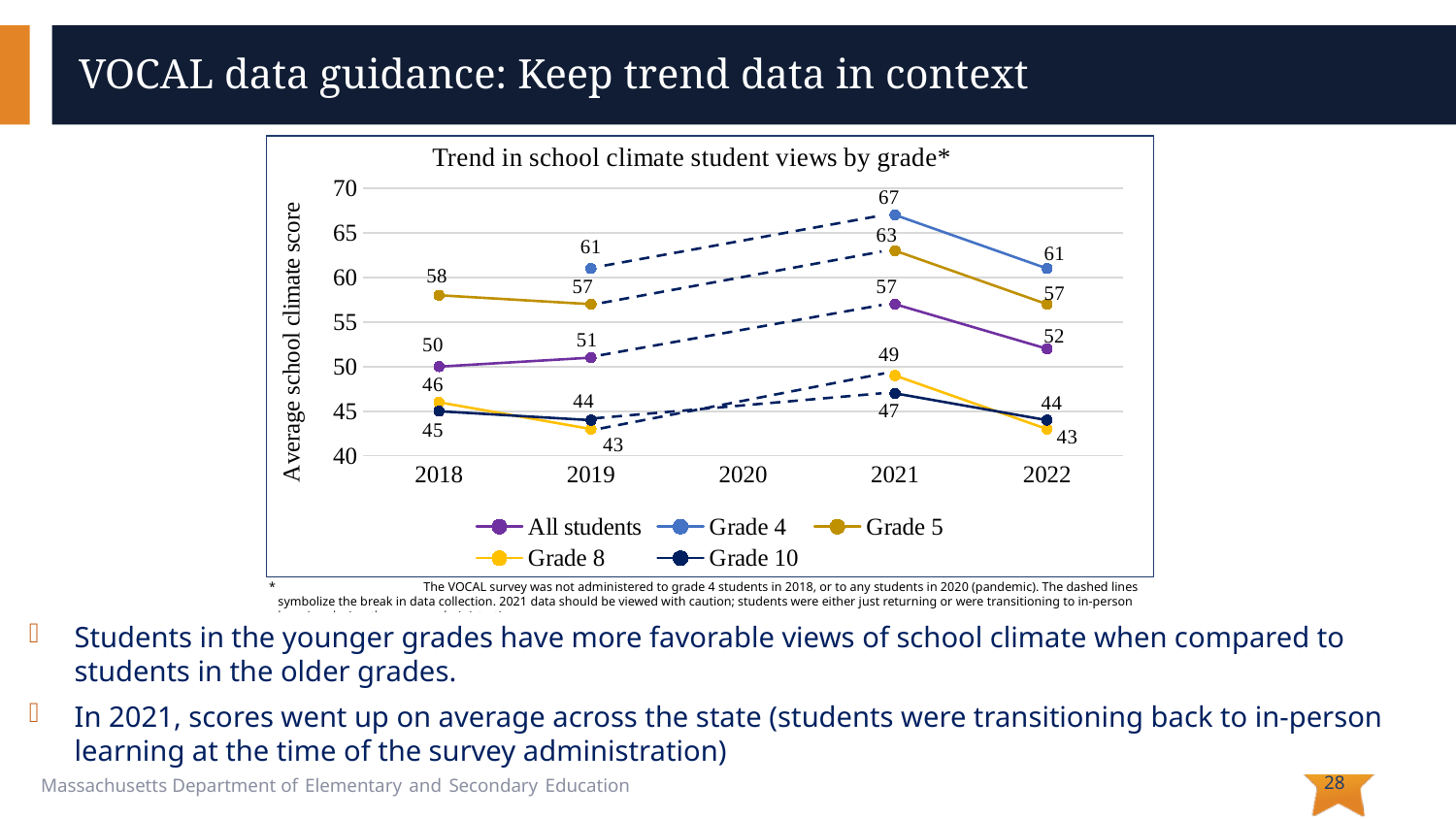
Which series has the lowest score in 2019? Grade 8 What is the title of the chart? Trend in school climate student views by grade* What is the Grade 8 average school climate score in 2022? 43 How many series does the legend list? 5 What kind of chart is shown on the slide? Line chart What is the All students average school climate score in 2018? 50 Does the All students score rise or fall from 2021 to 2022? Fall What is the Grade 4 average school climate score in 2021? 67 Which series has the highest score in 2021? Grade 4 What is the difference between the Grade 4 and Grade 5 scores in 2021? 4 What is the Grade 10 average school climate score in 2021? 47 Which is larger, the Grade 5 score in 2018 or the Grade 5 score in 2019? Grade 5 score in 2018